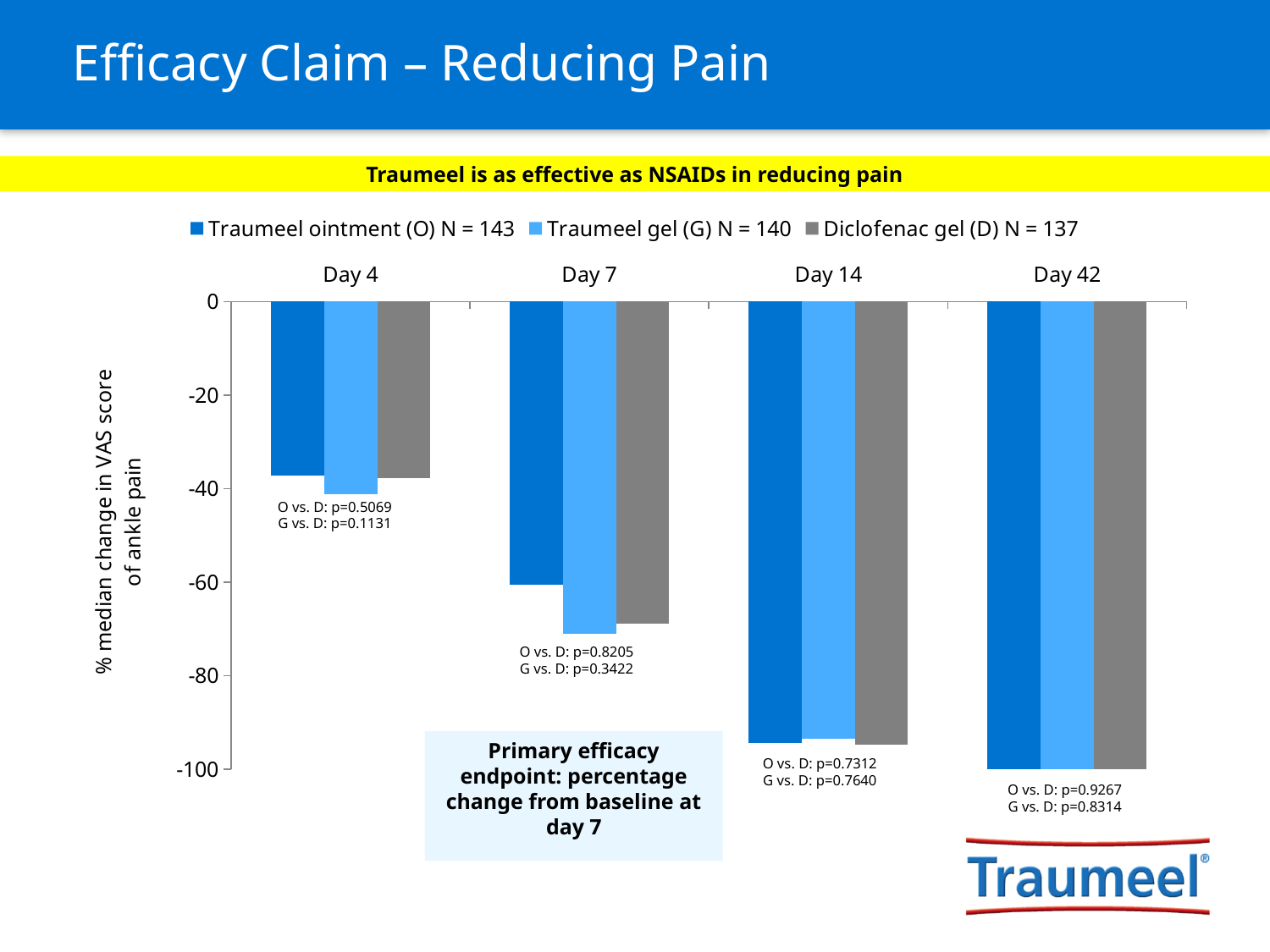
Is the value for Diclofenac gel (D) at Day 7 greater or less than -80? greater Is the value for Traumeel ointment (O) at Day 14 greater or less than -80? less What is the label of the y axis of the chart? % median change in VAS score of ankle pain How many time points (categories) are shown on the x axis of the chart? 4 What is the p-value for O vs. D at Day 7? p=0.8205 Is the value for Traumeel gel (G) at Day 7 greater or less than -60? less At Day 7, which has the larger (less negative) value: Traumeel ointment (O) or Traumeel gel (G)? Traumeel ointment (O) How many series does the chart legend list? 3 What kind of chart is shown on the slide? bar chart What is the sample size (N) for Diclofenac gel (D) shown in the legend? 137 Do the values for Traumeel ointment (O) rise or fall from Day 4 to Day 42? fall